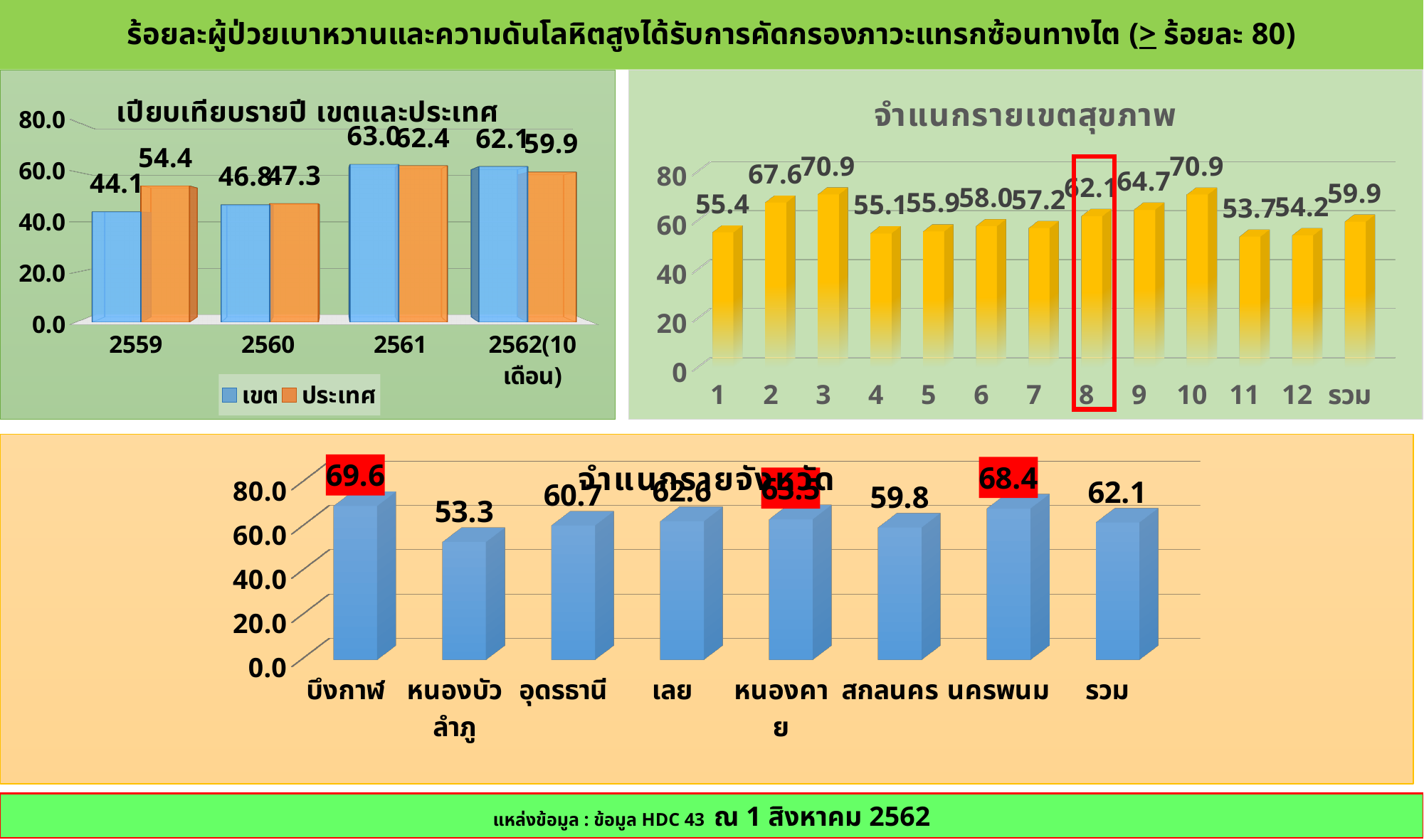
In the chart titled เปียบเทียบรายปี เขตและประเทศ, how many series does the legend list? 2 In the chart titled จำแนกรายเขตสุขภาพ, what is the value for category 8? 62.1 In the chart titled จำแนกรายเขตสุขภาพ, which category has the lowest value? 11 In the chart titled เปียบเทียบรายปี เขตและประเทศ, what is the value for ประเทศ in 2561? 62.4 In the chart titled จำแนกรายเขตสุขภาพ, how many categories are shown on the x axis? 13 What kind of chart is the chart titled จำแนกรายจังหวัด? bar chart In the chart titled จำแนกรายจังหวัด, which province has the highest value? บึงกาฬ In the chart titled เปียบเทียบรายปี เขตและประเทศ, what is the value for เขต in 2559? 44.1 In the chart titled จำแนกรายจังหวัด, what is the value for หนองบัวลำภู? 53.3 In the chart titled จำแนกรายเขตสุขภาพ, which is larger, the value for category 2 or category 9? category 2 In the chart titled เปียบเทียบรายปี เขตและประเทศ, does the เขต value rise or fall from 2559 to 2561? rise In the chart titled เปียบเทียบรายปี เขตและประเทศ, what is the difference between ประเทศ and เขต in 2559? 10.3